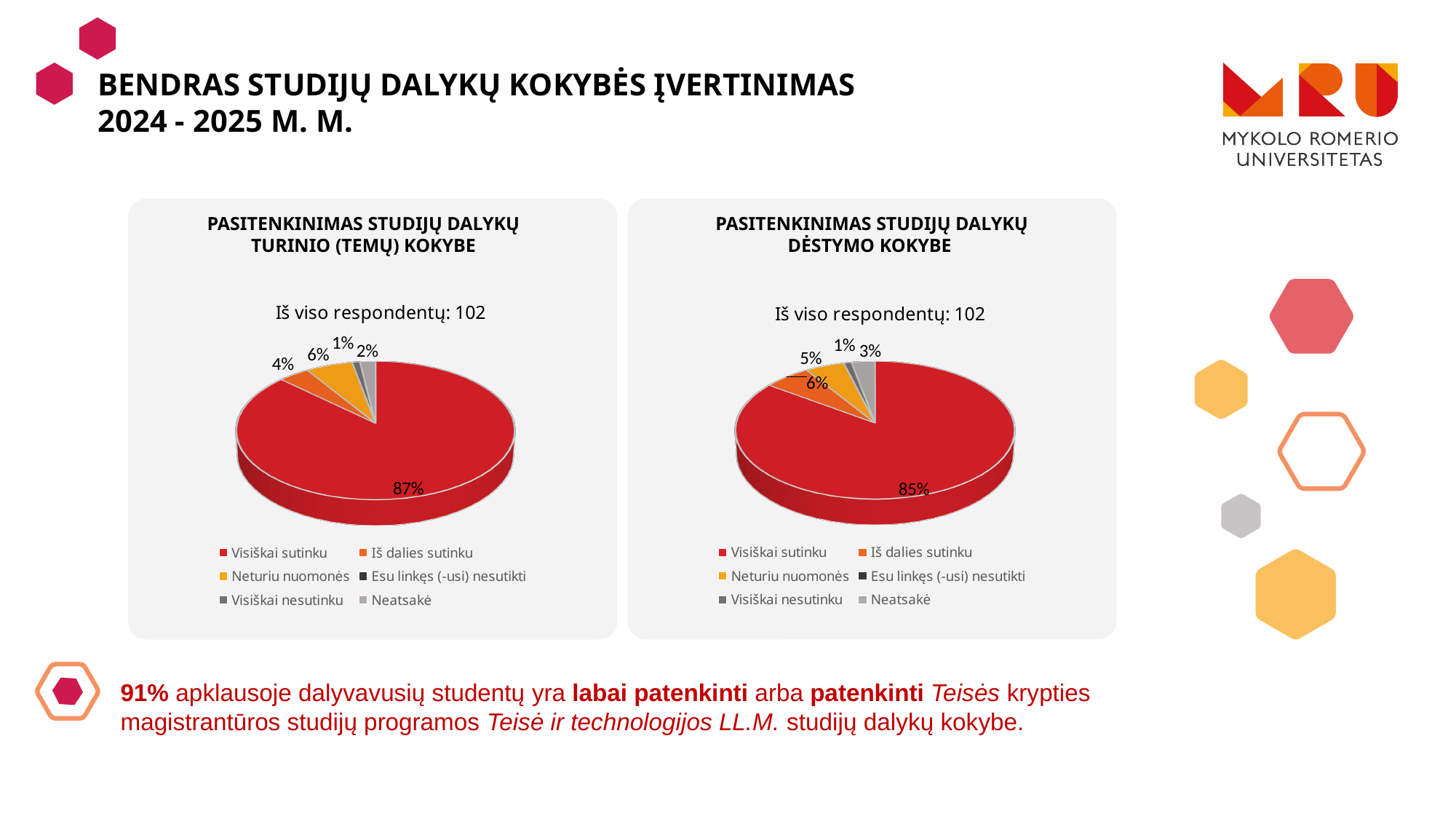
In the right chart (Pasitenkinimas studijų dalykų dėstymo kokybe), what share is labelled for "Iš dalies sutinku"? 6% In the right chart (Pasitenkinimas studijų dalykų dėstymo kokybe), what share is labelled for "Neturiu nuomonės"? 5% In the left chart (Pasitenkinimas studijų dalykų turinio (temų) kokybe), what share is labelled for "Neturiu nuomonės"? 6% Which chart shows a larger share for "Visiškai sutinku": the left chart (turinio kokybe) or the right chart (dėstymo kokybe)? The left chart (turinio kokybe) In the right chart (Pasitenkinimas studijų dalykų dėstymo kokybe), what share of respondents answered "Visiškai sutinku"? 85% In the left chart (Pasitenkinimas studijų dalykų turinio (temų) kokybe), what share of respondents answered "Visiškai sutinku"? 87% In the right chart (Pasitenkinimas studijų dalykų dėstymo kokybe), which category has the largest slice? Visiškai sutinku What is the difference between the "Visiškai sutinku" share in the left chart (87%) and in the right chart (85%)? 2% How many entries does the legend of the left chart (Pasitenkinimas studijų dalykų turinio (temų) kokybe) list? 6 In the left chart (Pasitenkinimas studijų dalykų turinio (temų) kokybe), what share is labelled for "Iš dalies sutinku"? 4% In the left chart (Pasitenkinimas studijų dalykų turinio (temų) kokybe), which category has the largest slice? Visiškai sutinku What type of chart is used on this slide? Pie chart